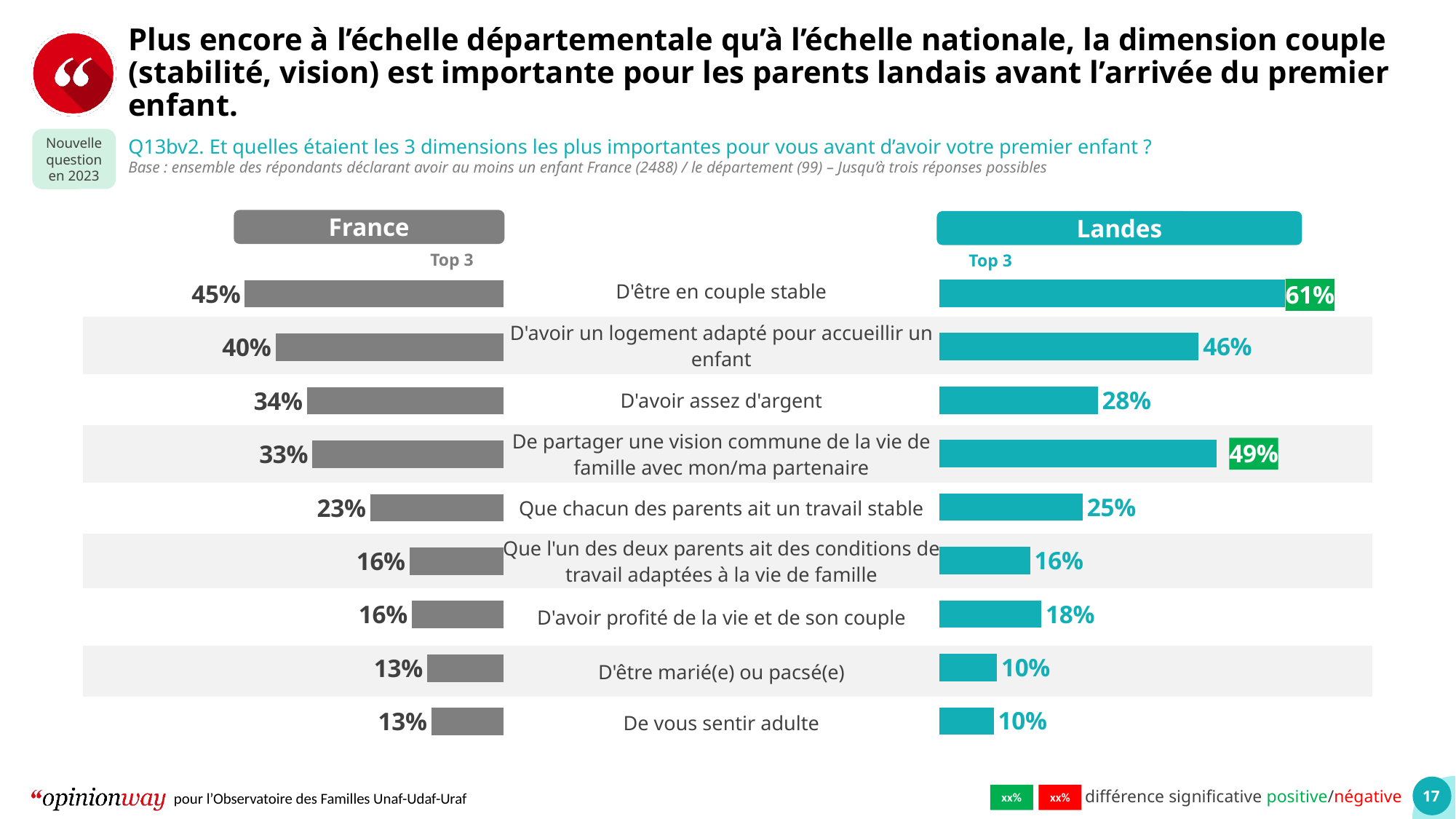
In the Landes chart, which category has the highest value? D'être en couple stable In the France chart, what is the value for "D'être marié(e) ou pacsé(e)"? 13% In the Landes chart, what is the value for "De partager une vision commune de la vie de famille avec mon/ma partenaire"? 49% In the France chart, what is the value for "D'être en couple stable"? 45% For "D'avoir assez d'argent", which is larger: the France value or the Landes value? France In the Landes chart, what is the value for "D'avoir assez d'argent"? 28% How many categories are shown in the France chart? 9 In the Landes chart, which values are highlighted in green as significantly positive differences? 61% and 49% In the France chart, which category has the highest value? D'être en couple stable What is the difference between the Landes and France values for "D'être en couple stable"? 16 points In the Landes chart, which is larger: "D'avoir un logement adapté pour accueillir un enfant" or "De partager une vision commune de la vie de famille avec mon/ma partenaire"? De partager une vision commune de la vie de famille avec mon/ma partenaire What kind of chart is used for the Landes data? Bar chart